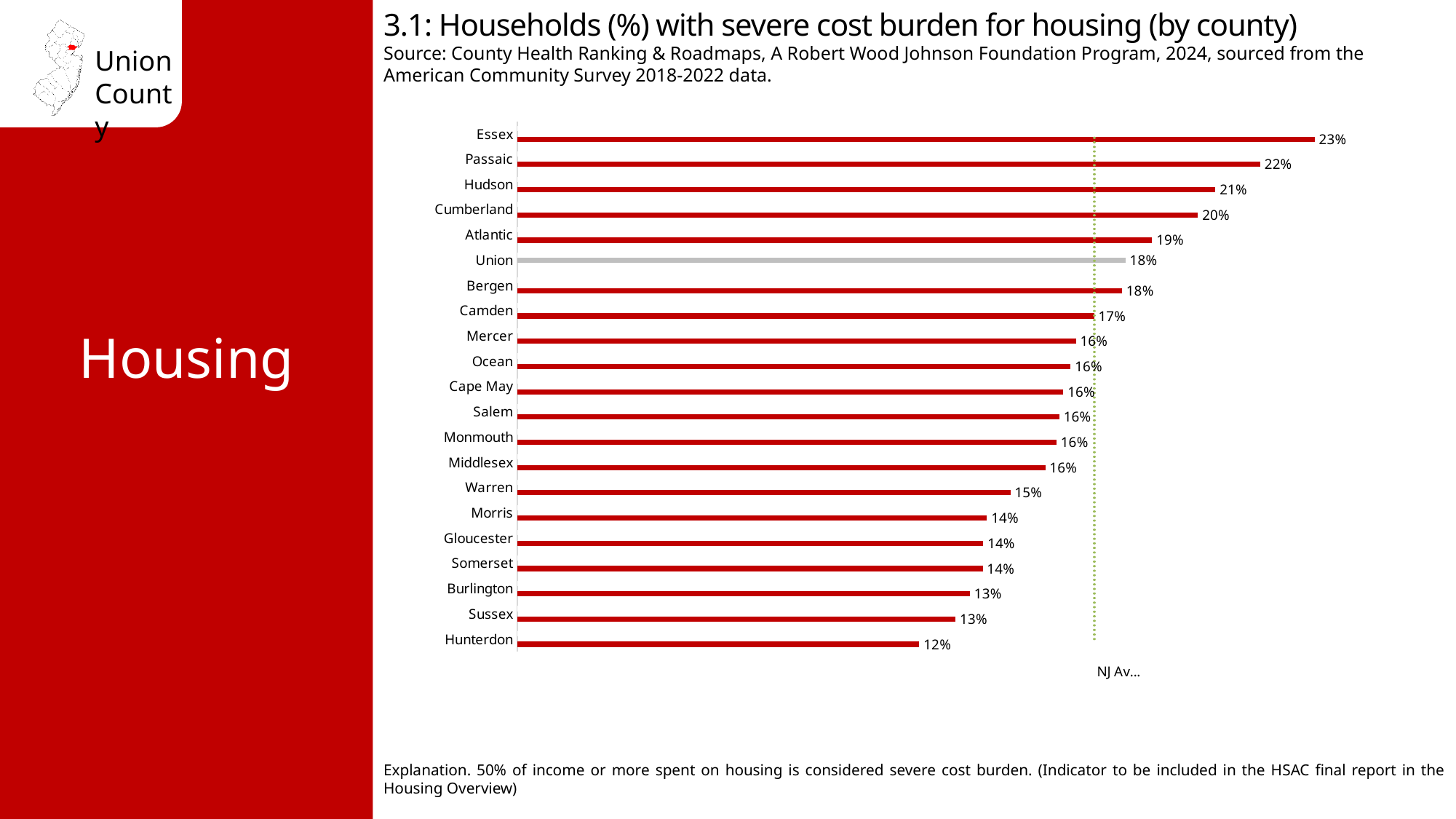
What is the value for Hunterdon? 12% Which county has the lowest percentage of households with severe cost burden? Hunterdon Which county's bar is shown in grey instead of red? Union What is the value for Essex? 23% Which is larger, the value for Passaic or the value for Atlantic? Passaic Which county has the highest percentage of households with severe cost burden? Essex How many counties are shown in the chart? 21 What is the difference between the values for Essex and Union? 5% Do the values rise or fall going from the top county to the bottom county? Fall What is the value for Union? 18% What kind of chart is shown on the slide? Bar chart What is the value for Cumberland? 20%